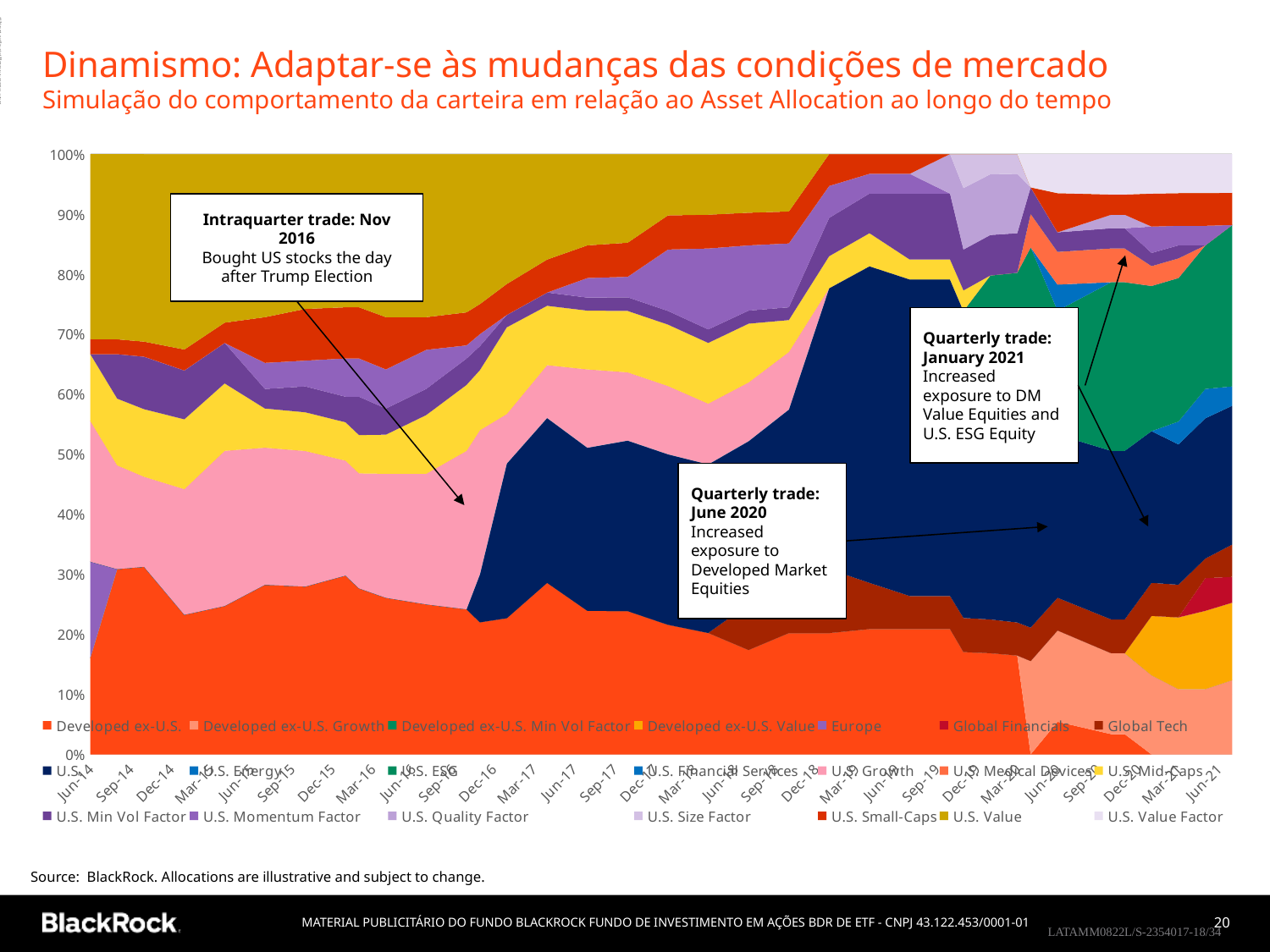
According to the annotation on the chart, when was the intraquarter trade that bought US stocks the day after the Trump election? Nov 2016 What is the maximum value shown on the y axis of the chart? 100% How many series does the chart's legend list? 21 According to the annotation on the chart, what trade was made in June 2020? Increased exposure to Developed Market Equities What is the last date shown on the x axis of the chart? Jun-21 What kind of chart is shown on the slide? Stacked area chart What is the first date shown on the x axis of the chart? Jun-14 How many quarterly dates are labelled along the x axis of the chart? 29 What is the interval between consecutive tick labels on the y axis of the chart? 10%